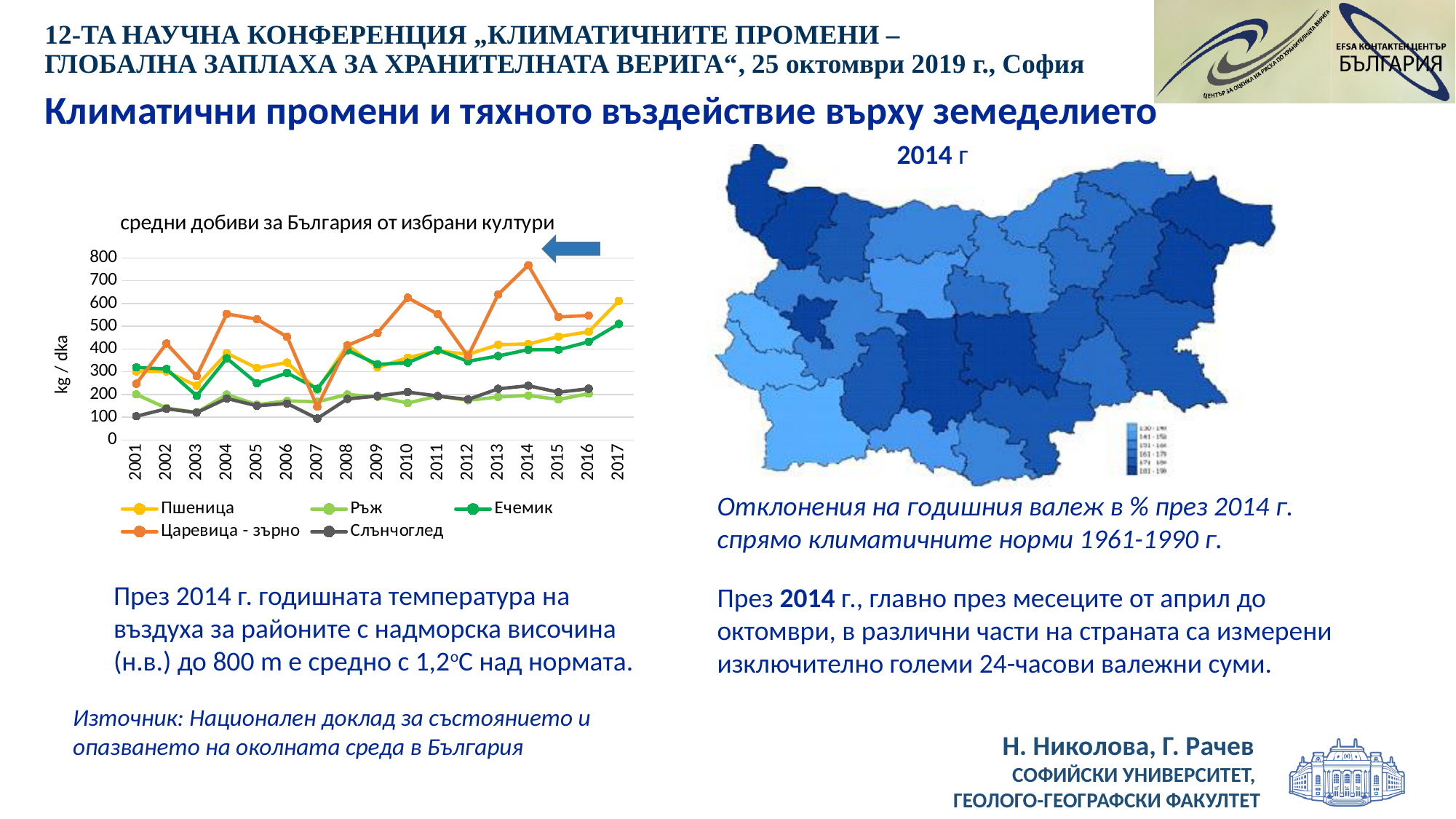
In the chart "средни добиви за България от избрани култури", is the value for Царевица - зърно in 2014 greater or less than 700? greater What is the y-axis label of the chart "средни добиви за България от избрани култури"? kg / dka In the chart "средни добиви за България от избрани култури", in which year does Царевица - зърно reach its highest value? 2014 In the chart "средни добиви за България от избрани култури", which series has the highest value in 2014? Царевица - зърно What kind of chart is "средни добиви за България от избрани култури"? line chart In the chart "средни добиви за България от избрани култури", which is larger in 2007: Ръж or Слънчоглед? Ръж How many series does the legend of the chart "средни добиви за България от избрани култури" list? 5 In the chart "средни добиви за България от избрани култури", does the value for Слънчоглед rise or fall overall from 2001 to 2017? rise In the chart "средни добиви за България от избрани култури", is the value for Царевица - зърно in 2007 greater or less than 200? less How many years are shown on the x axis of the chart "средни добиви за България от избрани култури"? 17 In the chart "средни добиви за България от избрани култури", in which year does Слънчоглед reach its lowest value? 2007